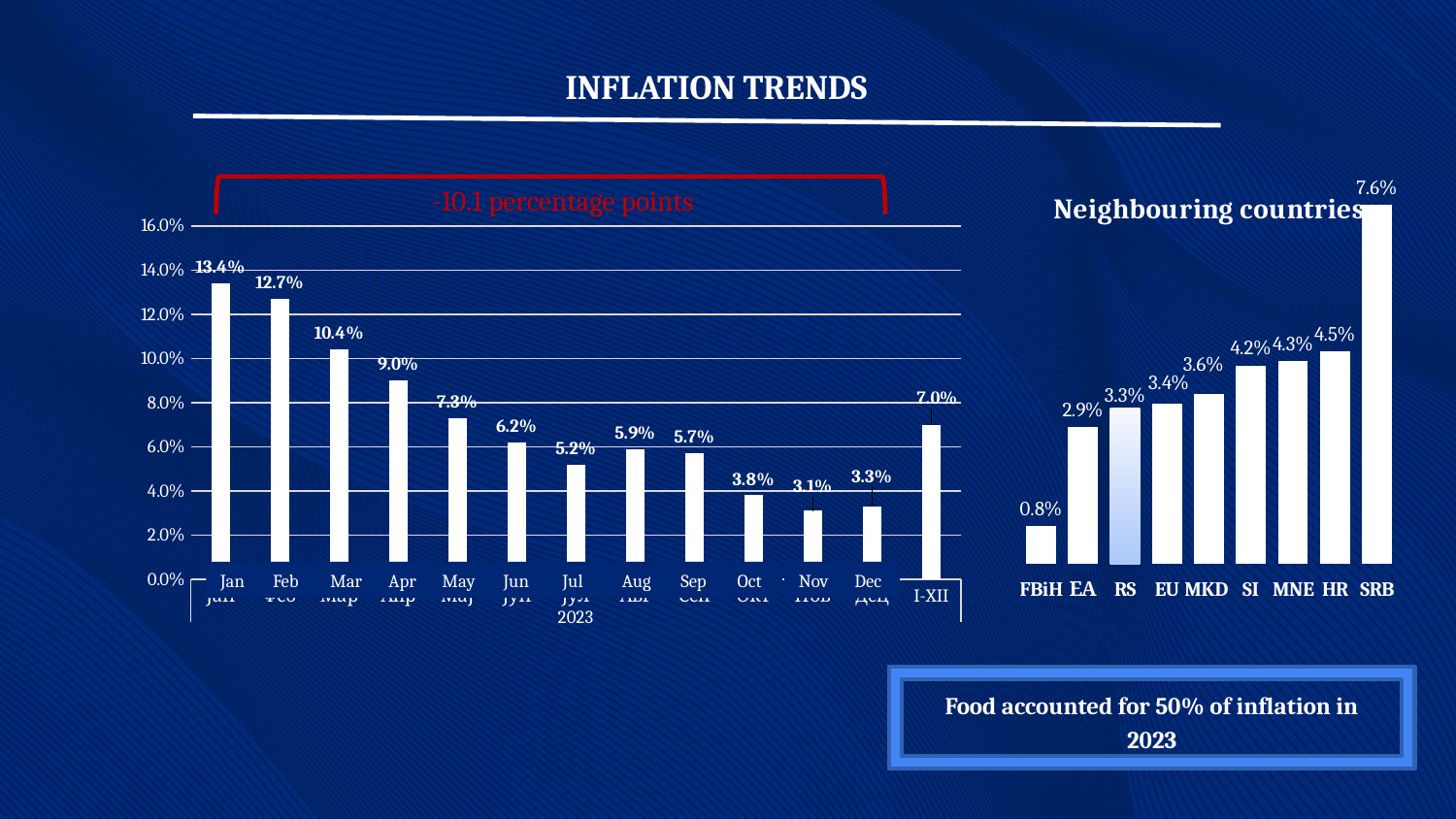
In the monthly inflation chart on the left, what is the value for I-XII? 7.0% In the monthly inflation chart on the left, which month has the lowest value? Nov In the monthly inflation chart on the left, what is the difference between the Jan and Dec values? 10.1 percentage points In the monthly inflation chart on the left, which is larger, the value for Aug or the value for Sep? Aug In the Neighbouring countries chart, which country has the lowest value? FBiH What kind of chart is the Neighbouring countries chart? bar chart In the monthly inflation chart on the left, what is the value for Jan? 13.4% In the monthly inflation chart on the left, what is the value for Aug? 5.9% In the Neighbouring countries chart, what is the value for RS? 3.3% In the Neighbouring countries chart, which country has the highest value? SRB In the monthly inflation chart on the left, do the values generally rise or fall from Jan to Dec? fall In the Neighbouring countries chart, how many countries or regions are shown? 9